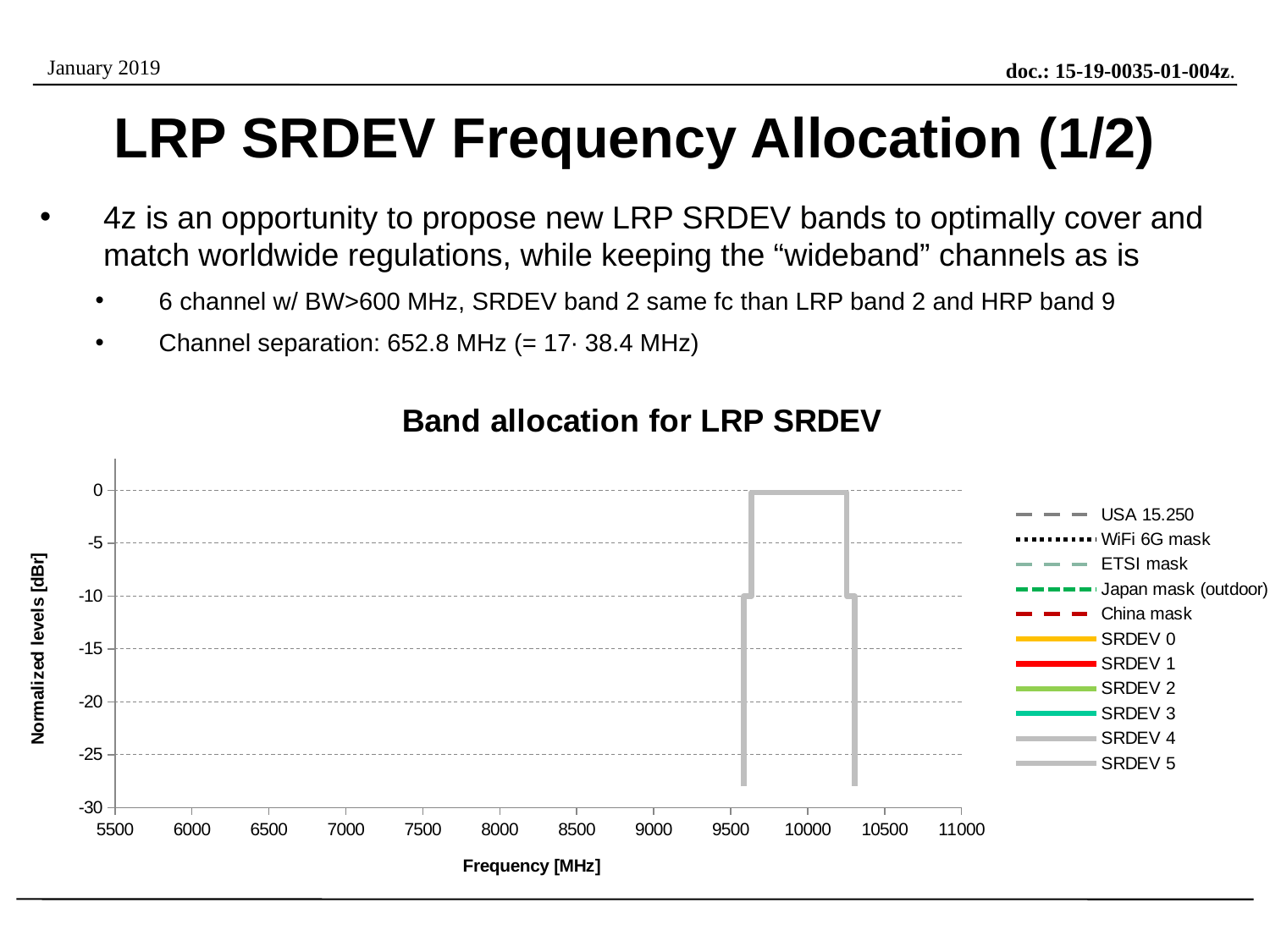
At what level does the plotted line step down to on either side of its flat top, as read on the y axis? -10 At 10000 MHz, is the plotted level greater or less than -5? greater What is the lowest tick value shown on the x axis of the chart? 5500 What kind of chart is shown on the slide? line chart How many series does the chart's legend list? 11 What is the title of the chart on the slide? Band allocation for LRP SRDEV What is the highest tick value shown on the x axis of the chart? 11000 What is the highest level reached by the plotted line in the chart, as read on the y axis? 0 What is the lowest tick value shown on the y axis of the chart? -30 What is the label of the x axis of the chart? Frequency [MHz]